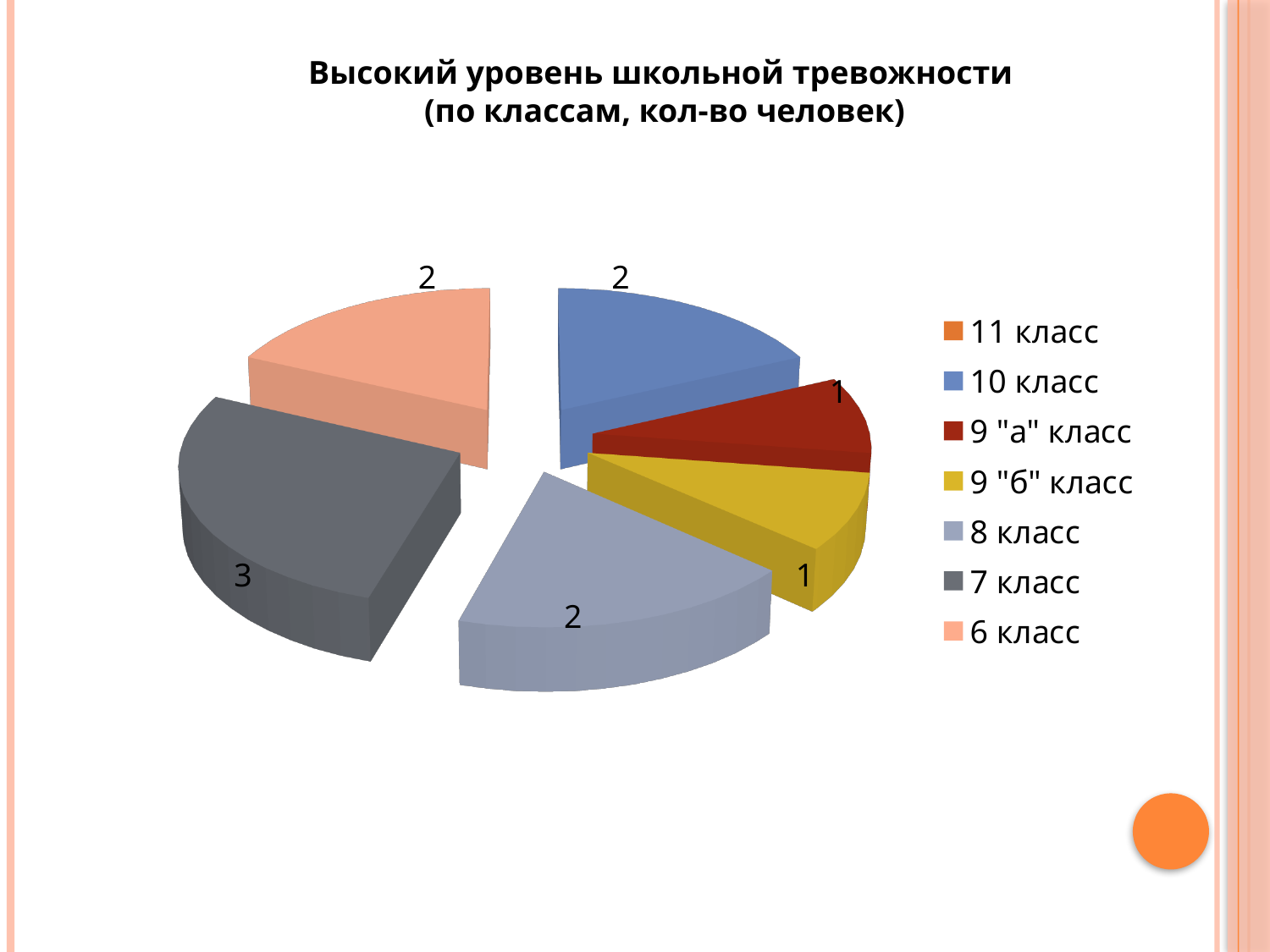
How many entries does the legend list? 7 Which is larger, the value for 7 класс or the value for 10 класс? 7 класс What is the value for 10 класс? 2 What kind of chart is shown on the slide? pie chart What is the value for 8 класс? 2 Which class has the largest slice of the pie? 7 класс What is the value for 9 "а" класс? 1 What is the difference between the values for 7 класс and 9 "а" класс? 2 What is the title of the chart? Высокий уровень школьной тревожности (по классам, кол-во человек) How many people are shown for 7 класс? 3 What is the value for 9 "б" класс? 1 What is the value for 6 класс? 2